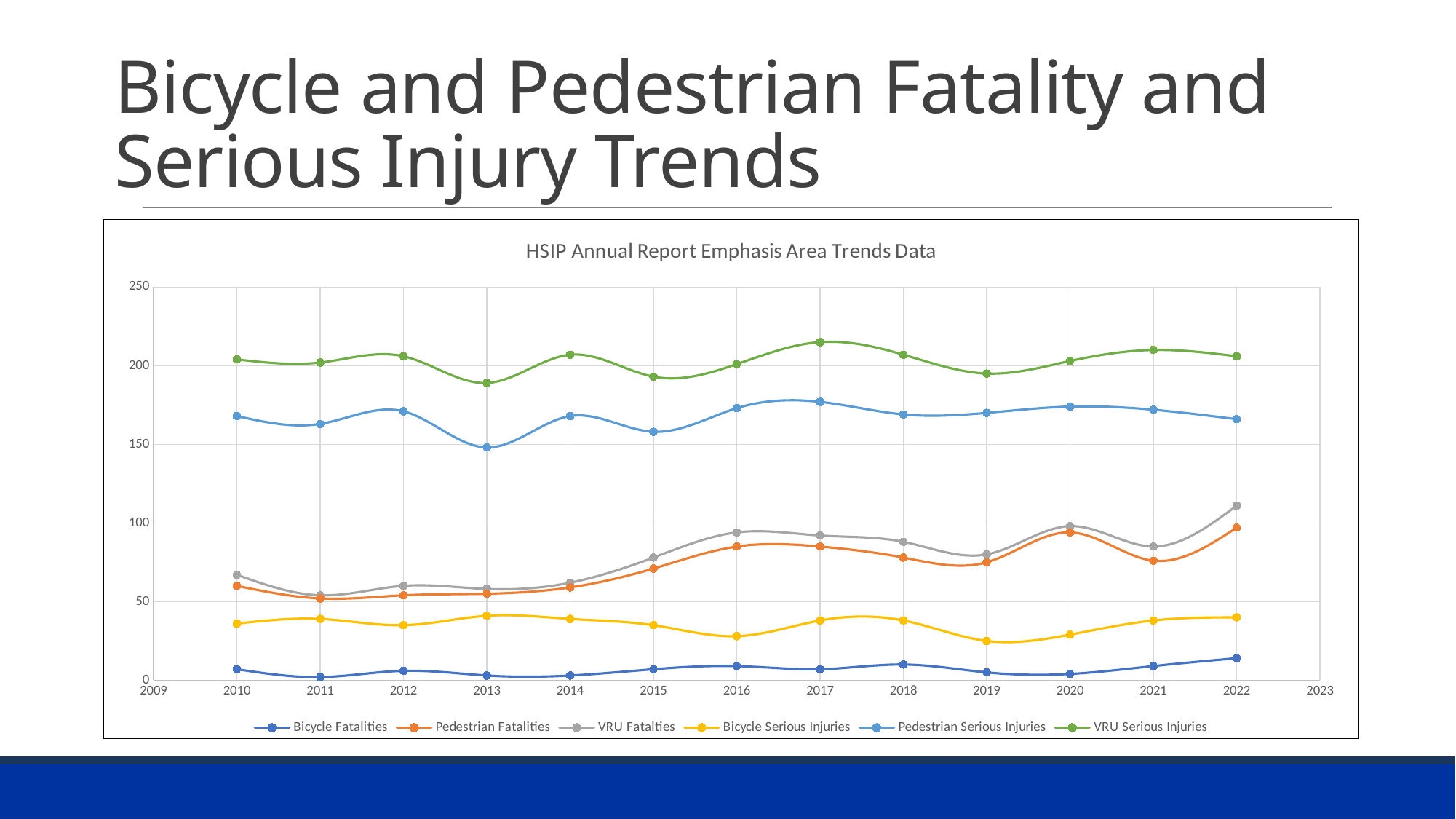
Which series has the lowest values across the chart? Bicycle Fatalities Is the value for VRU Serious Injuries in 2013 greater or less than 200? less Is the value for Pedestrian Serious Injuries in 2017 greater or less than 150? greater What is the title of the chart? HSIP Annual Report Emphasis Area Trends Data In which year is VRU Fatalities at its highest? 2022 How many years have data points plotted on the chart? 13 Is the value for Bicycle Serious Injuries in 2016 greater or less than 50? less What kind of chart is shown on the slide? line chart In which year is Pedestrian Serious Injuries at its lowest? 2013 How many series does the legend list? 6